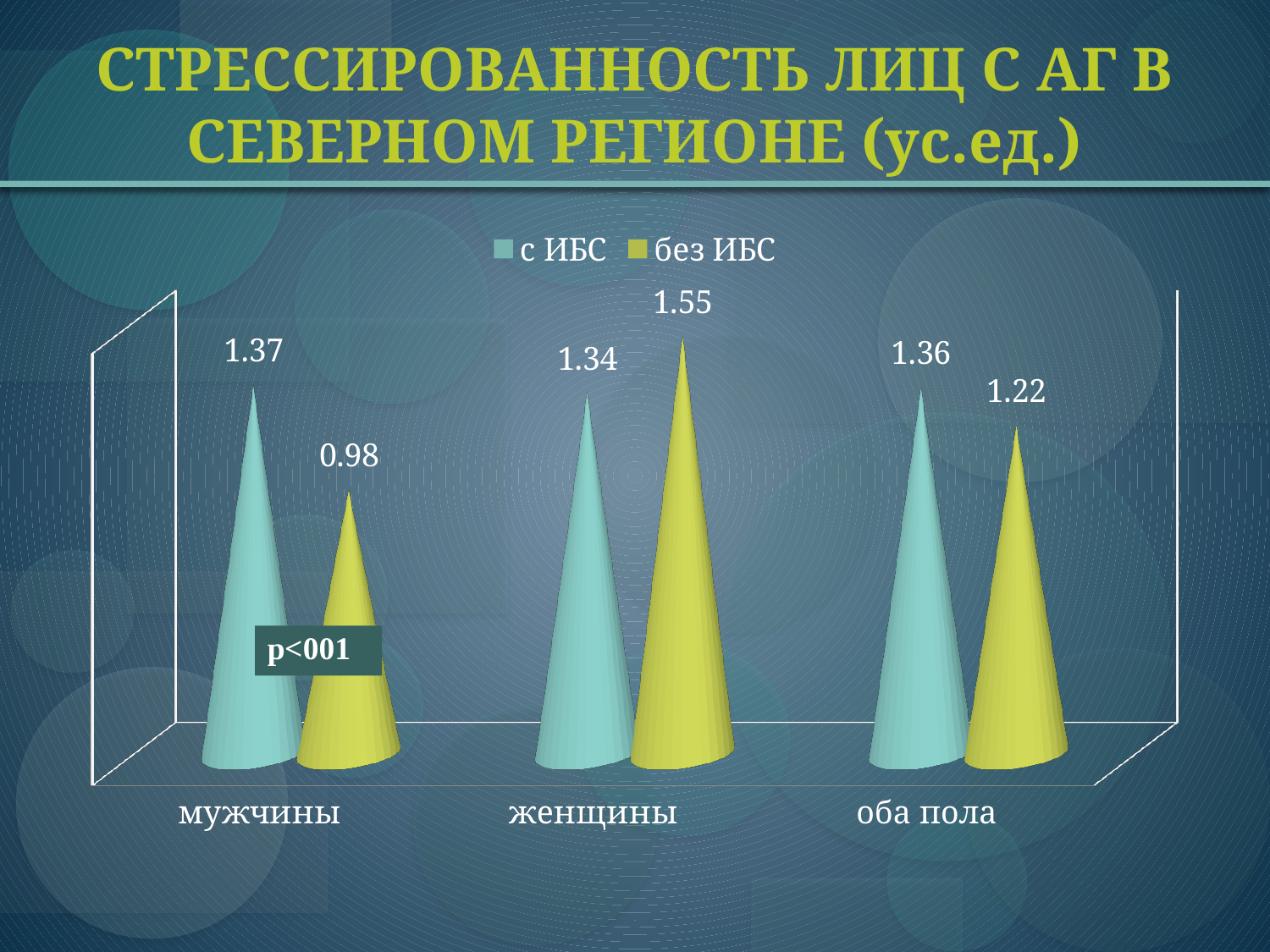
What is the difference between the "с ИБС" and "без ИБС" values in the "мужчины" category? 0.39 In the "оба пола" category, which series has the larger value, "с ИБС" or "без ИБС"? с ИБС What is the difference between the "без ИБС" and "с ИБС" values in the "женщины" category? 0.21 What is the value for "без ИБС" in the "женщины" category? 1.55 How many series does the legend list? 2 Which category has the lowest value for the "без ИБС" series? мужчины How many categories are shown on the x axis? 3 What is the value for "без ИБС" in the "мужчины" category? 0.98 What is the value for "с ИБС" in the "оба пола" category? 1.36 What is the value for "с ИБС" in the "мужчины" category? 1.37 Which category has the highest value for the "без ИБС" series? женщины What kind of chart is shown on the slide? bar chart